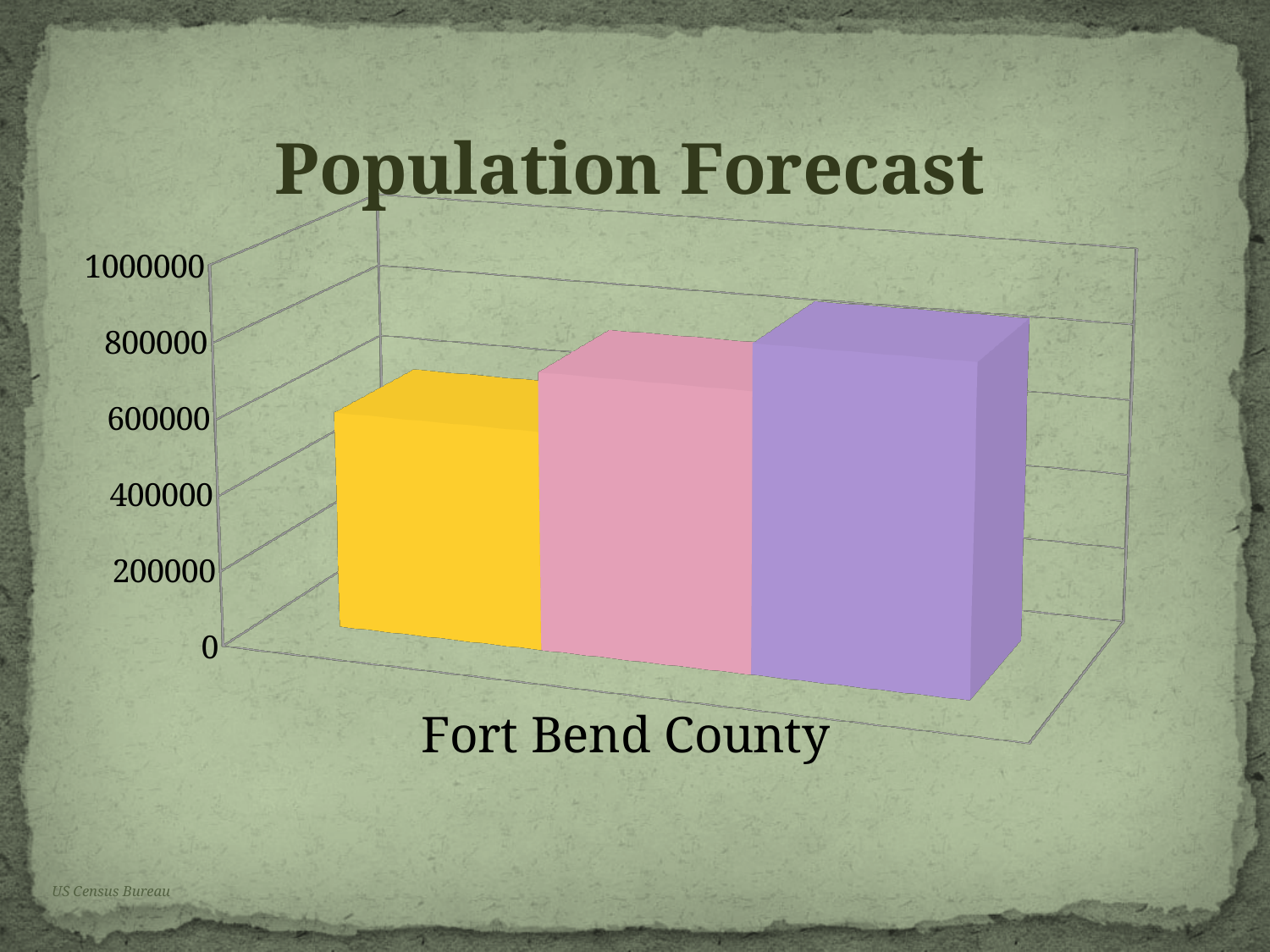
Which is larger, the pink bar or the yellow bar? pink What is the title of the chart? Population Forecast Is the value of the purple bar greater or less than 1000000? less Which bar is the tallest: the yellow, pink or purple one? purple Which bar is the shortest: the yellow, pink or purple one? yellow Is the value of the yellow bar greater or less than 800000? less How many bars are plotted for Fort Bend County? 3 What kind of chart is shown on the slide? bar chart What is the category label shown on the x axis? Fort Bend County Is the value of the yellow bar greater or less than 400000? greater Do the bar values rise or fall from left to right? rise